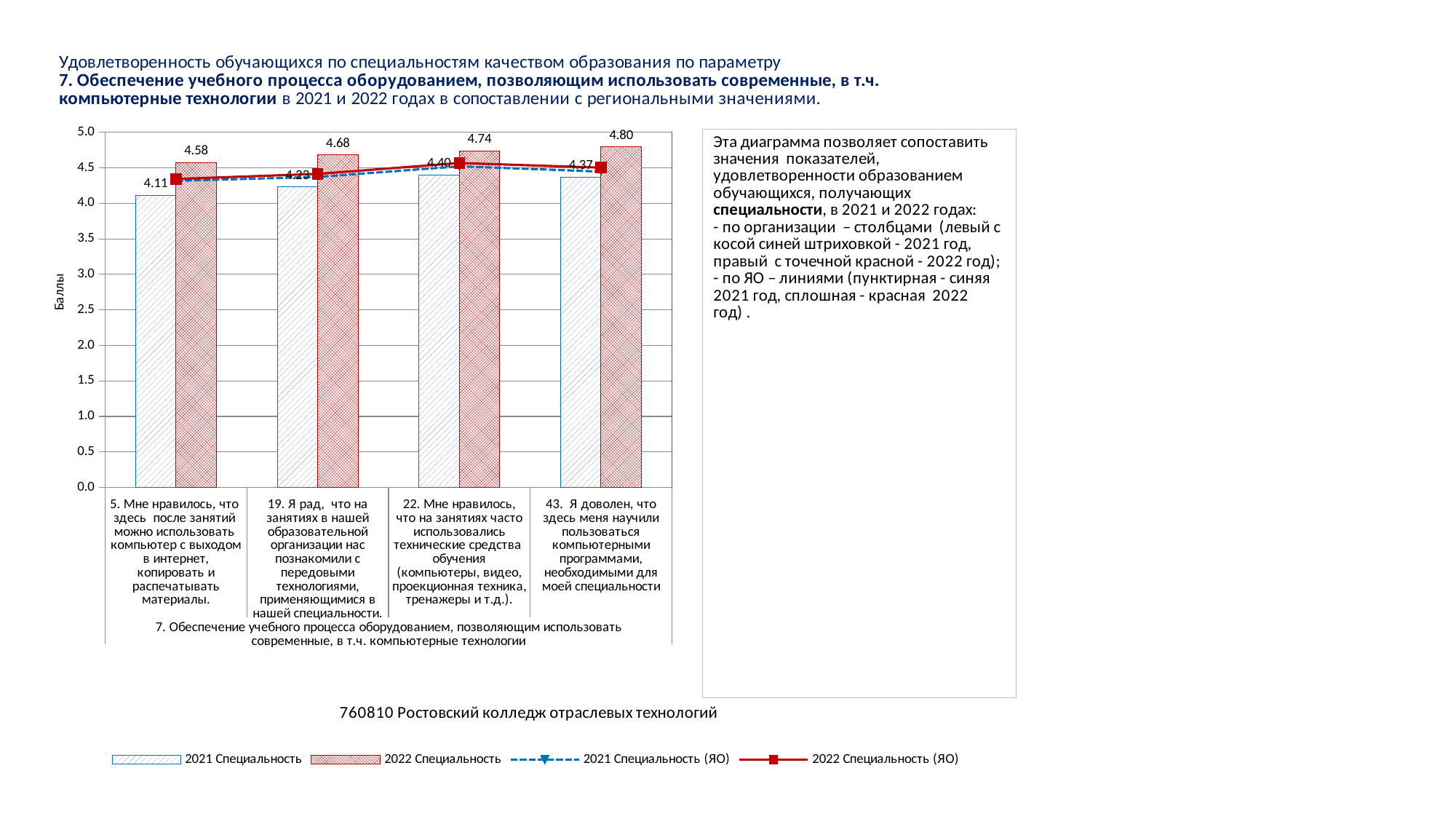
How many series does the chart legend list? 4 Which has the larger 2022 Специальность value: category 19 or category 22? 22. Мне нравилось, что на занятиях часто использовались технические средства обучения Do the 2022 Специальность bar values rise or fall from left to right across the categories? rise Is the 2021 Специальность value for category 22 ("Мне нравилось, что на занятиях часто использовались технические средства обучения") greater or less than 4.0? greater What kind of chart is shown on the slide? Combined bar and line chart What is the 2021 Специальность value for the category "5. Мне нравилось, что здесь после занятий можно использовать компьютер с выходом в интернет, копировать и распечатывать материалы."? 4.11 Which category has the highest 2022 Специальность value? 43. Я доволен, что здесь меня научили пользоваться компьютерными программами, необходимыми для моей специальности Which category has the lowest 2021 Специальность value? 5. Мне нравилось, что здесь после занятий можно использовать компьютер с выходом в интернет, копировать и распечатывать материалы. How many categories are shown on the x axis of the chart? 4 What is the 2022 Специальность value for the category "5. Мне нравилось, что здесь после занятий можно использовать компьютер с выходом в интернет, копировать и распечатывать материалы."? 4.58 For category 5 ("Мне нравилось, что здесь после занятий можно использовать компьютер..."), how much higher is the 2022 Специальность value than the 2021 Специальность value? 0.47 What is the 2022 Специальность value for the category "43. Я доволен, что здесь меня научили пользоваться компьютерными программами, необходимыми для моей специальности"? 4.80